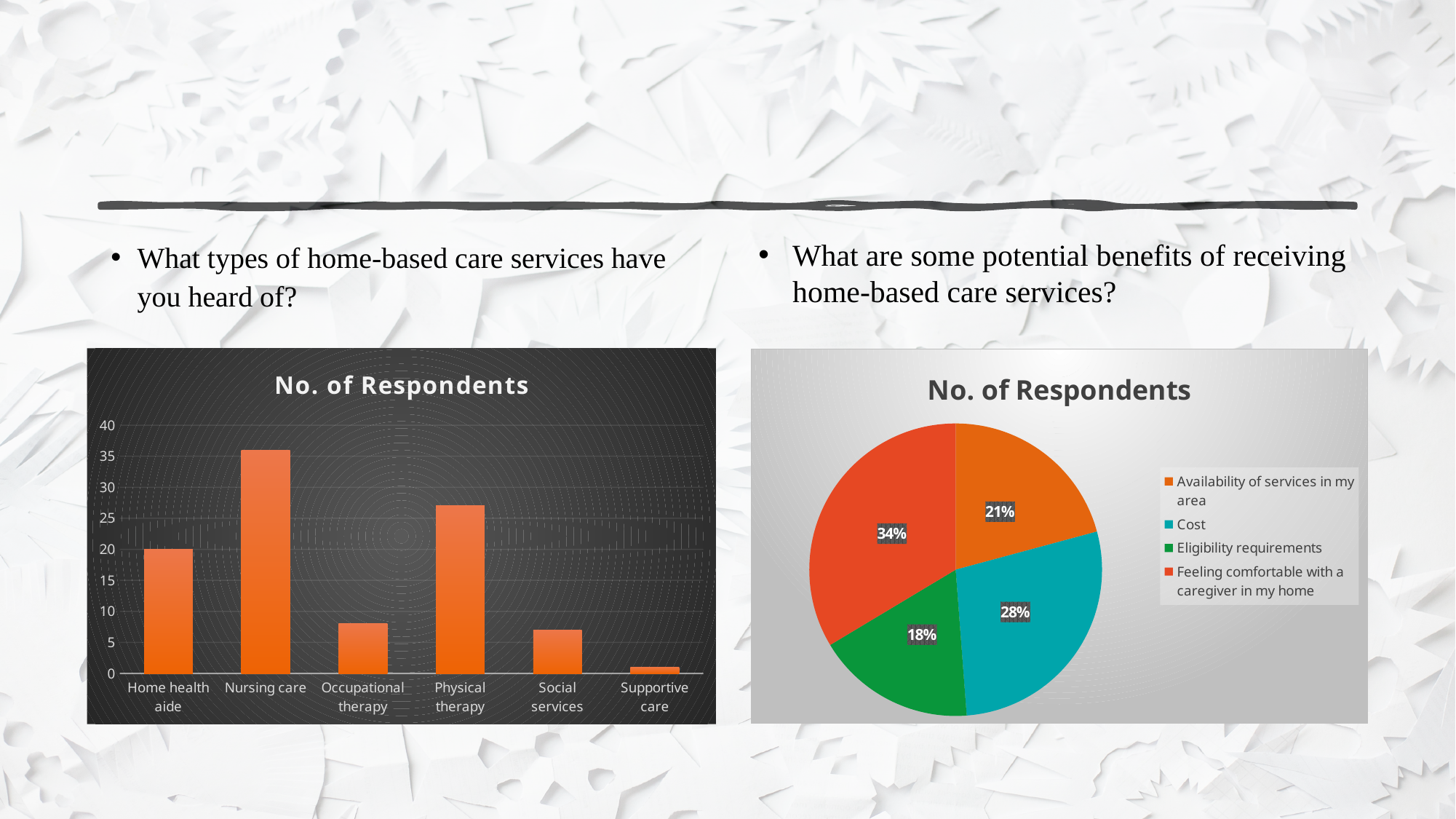
On the right pie chart, what share of respondents chose Cost? 28% On the left bar chart, which is larger, the value for Home health aide or the value for Social services? Home health aide On the left bar chart, is the value for Occupational therapy greater or less than 10? less On the left bar chart, which category has the lowest number of respondents? Supportive care On the left bar chart, is the value for Physical therapy greater or less than 25? greater On the right pie chart, what is the difference between the share for Feeling comfortable with a caregiver in my home and the share for Eligibility requirements? 16% How many entries does the legend of the right pie chart list? 4 On the left bar chart, is the value for Nursing care greater or less than 35? greater What kind of chart is the chart on the left of the slide? Bar chart How many categories are shown on the left bar chart? 6 On the right pie chart, which benefit has the largest share? Feeling comfortable with a caregiver in my home On the left bar chart, which category has the highest number of respondents? Nursing care